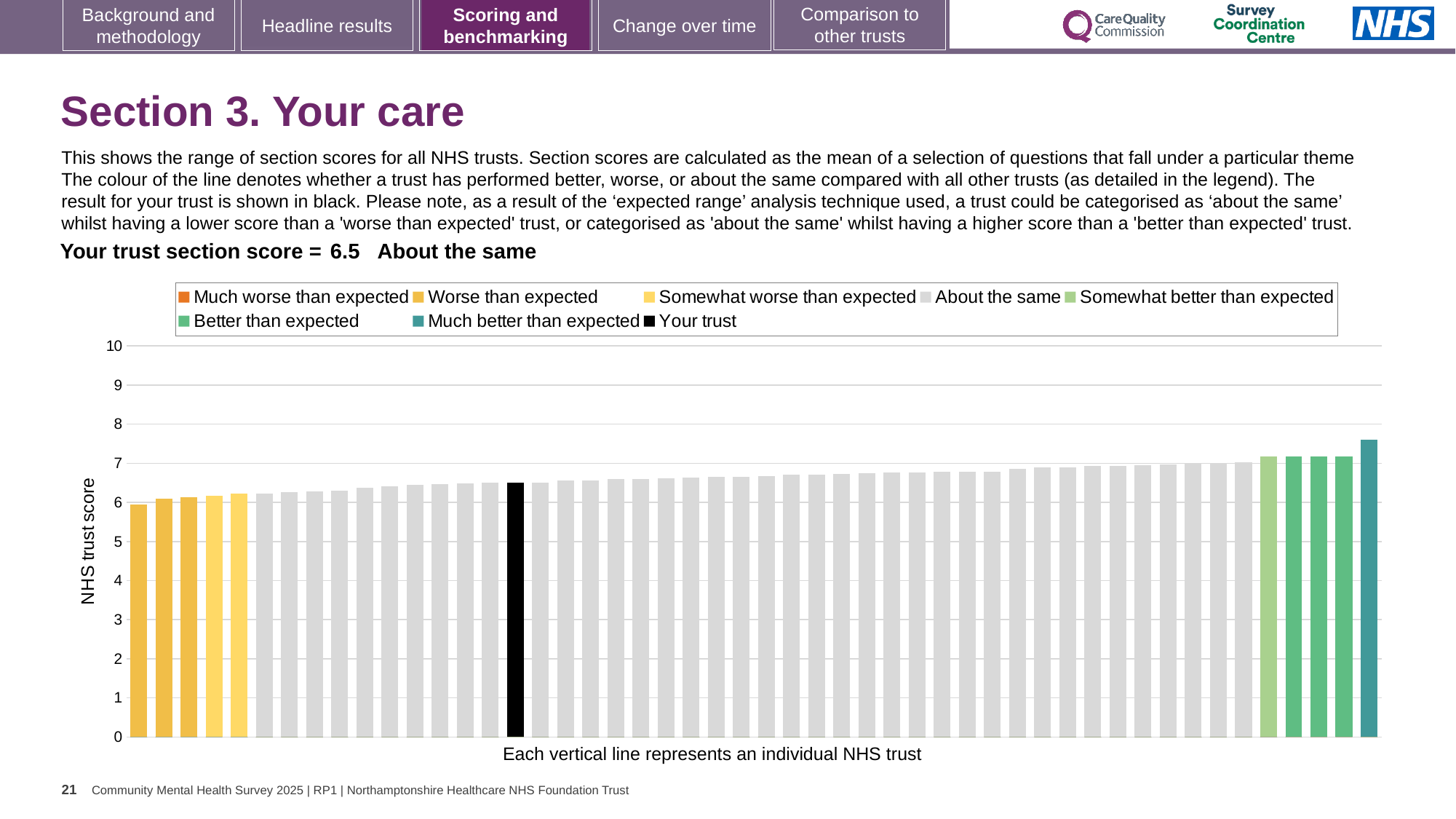
What colour is used in the chart to show your trust? Black What is the section score for your trust shown on the slide? 6.5 Is the value of the black bar (your trust) greater or less than 6? greater Is the value of the black bar (your trust) greater or less than 7? less Do the bar values rise or fall moving from left to right along the x axis? rise Is the value of the tallest bar (the rightmost, 'Much better than expected' trust) greater or less than 7? greater Which category is your trust placed in for this section? About the same What is the label on the vertical axis of the chart? NHS trust score What kind of chart is shown on the slide? Bar chart How many entries does the chart legend list? 8